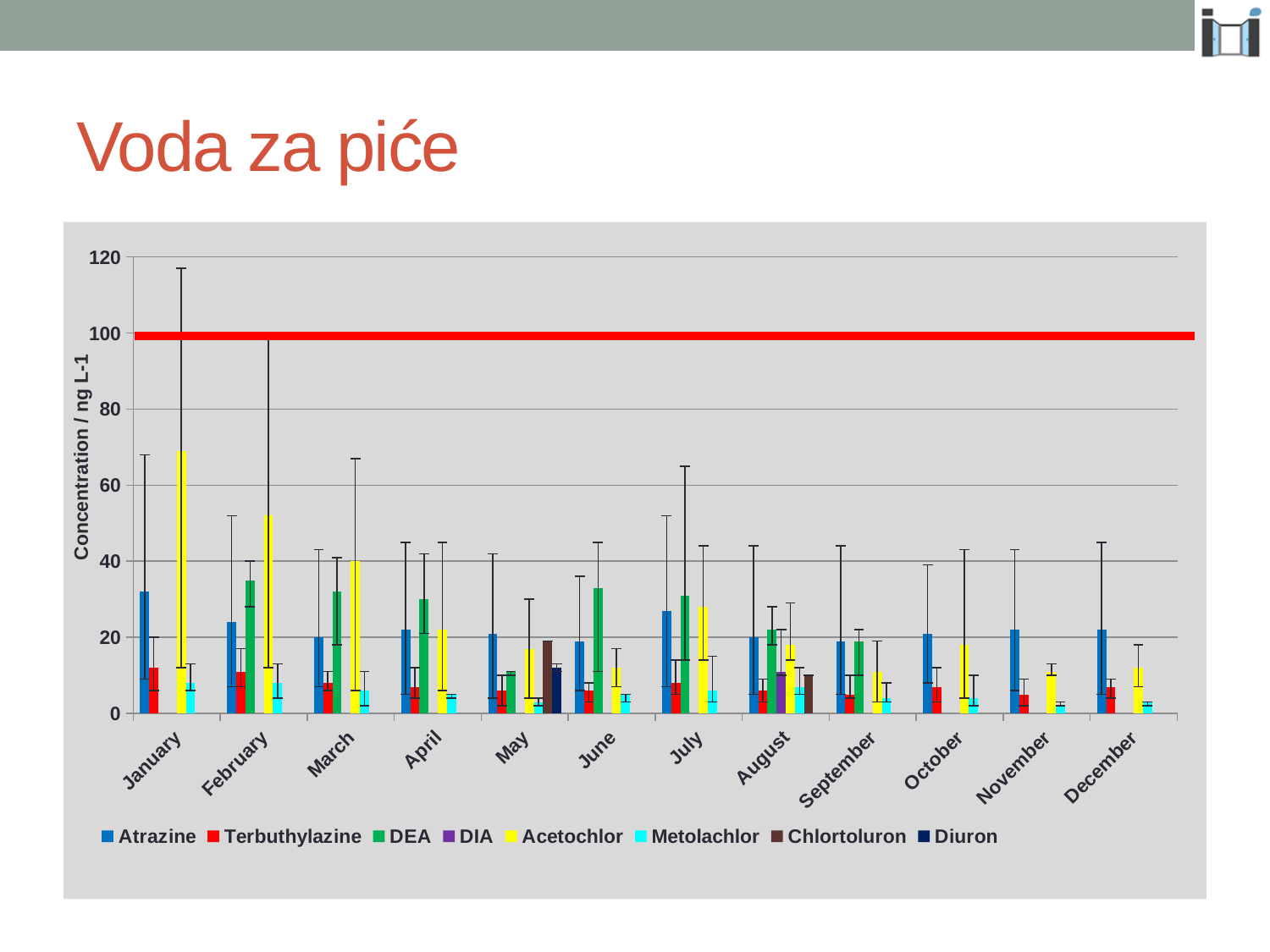
How many months are shown along the x axis? 12 At what y-axis value is the thick red horizontal line drawn? 100 How many series does the legend list? 8 Is the value for Acetochlor in March greater or less than 20? greater What is the y-axis title of the chart? Concentration / ng L-1 In which month is the Acetochlor bar highest? January What kind of chart is shown on the slide? bar chart Is the value for Acetochlor in January greater or less than 60? greater Is the value for Terbuthylazine in January greater or less than 20? less In June, which is larger: DEA or Atrazine? DEA In February, which is larger: Acetochlor or Atrazine? Acetochlor